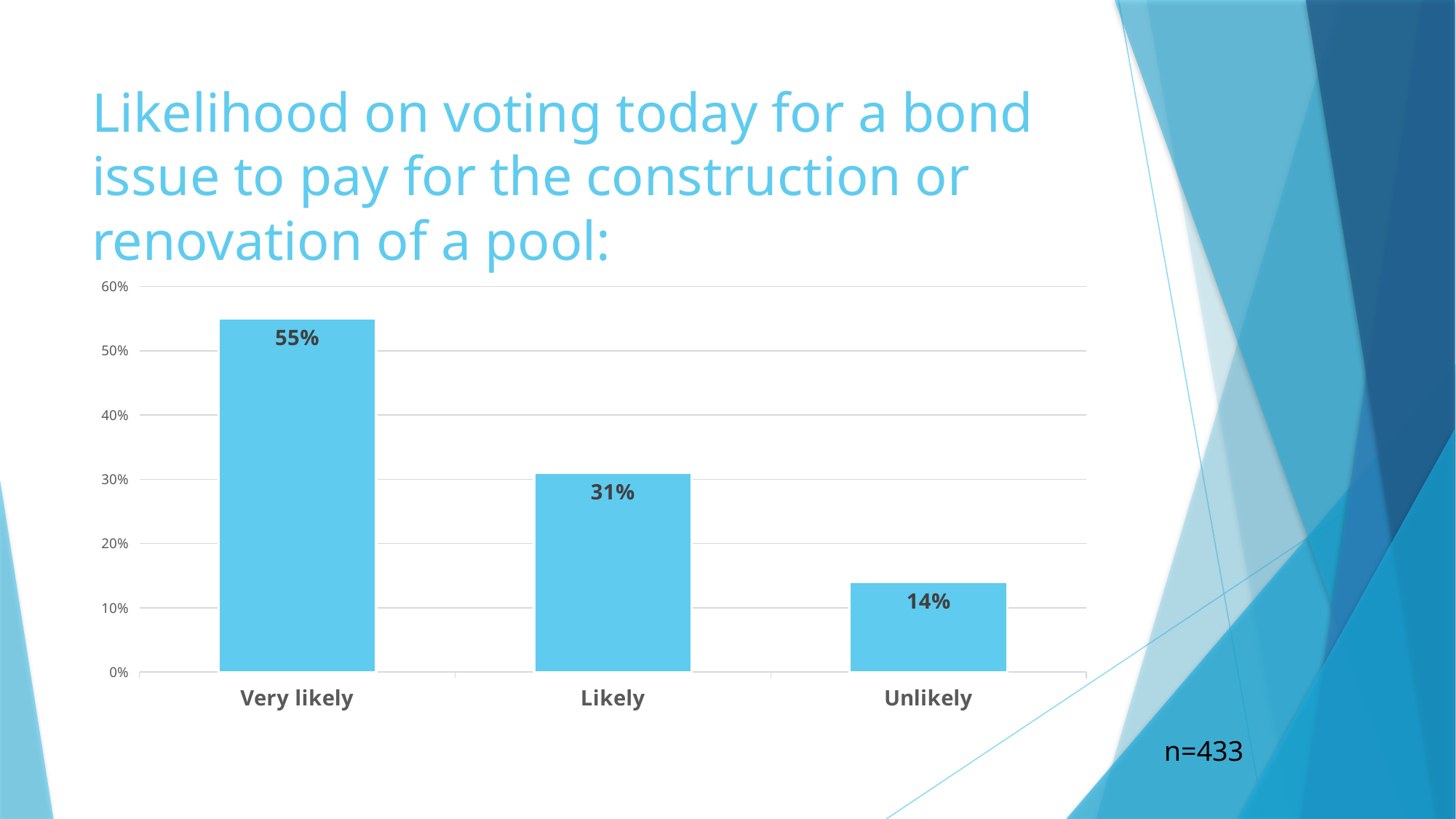
Do the values rise or fall from left to right along the x axis? fall What is the difference between the values for Likely and Unlikely? 17% Which category has the lowest value? Unlikely What is the value for Likely? 31% What kind of chart is shown on the slide? bar chart Is the value for Likely greater or less than 40%? less What is the value for Very likely? 55% What is the value for Unlikely? 14% How many categories are shown on the x axis? 3 Which category has the highest value? Very likely What is the difference between the values for Very likely and Likely? 24% Which is larger, the value for Likely or the value for Unlikely? Likely